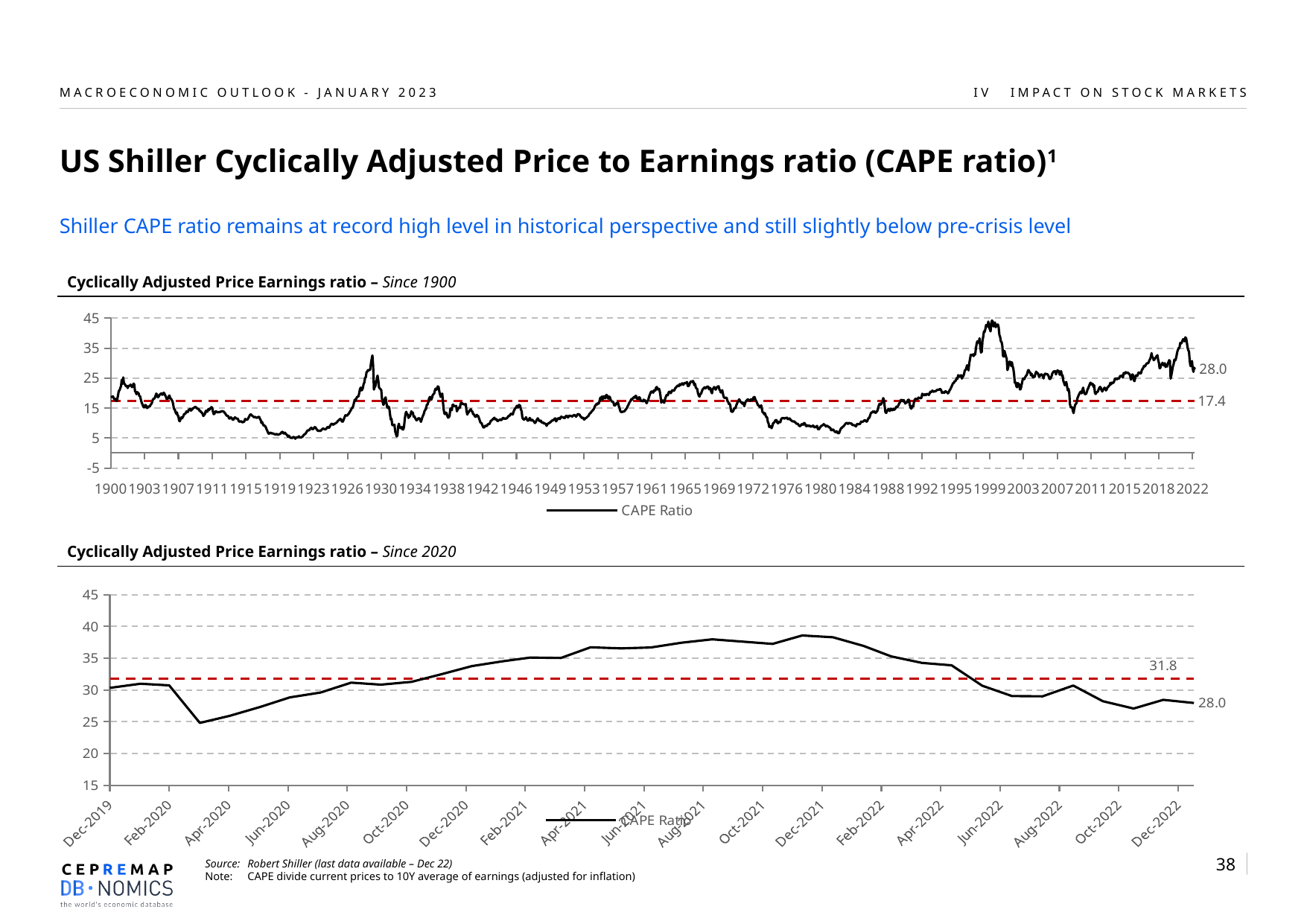
In the 'Since 2020' chart, what is the difference between the dashed line value and the latest CAPE Ratio value? 3.8 In the 'Since 1900' chart, what is the latest CAPE Ratio value labelled at the end of the line? 28.0 How many series does the legend of the 'Since 2020' chart list? 1 In the 'Since 1900' chart, what value is labelled on the dashed red horizontal line? 17.4 In the 'Since 2020' chart, does the CAPE Ratio rise or fall between Dec-2021 and Dec-2022? Fall In the 'Since 2020' chart, at which x-axis label is the CAPE Ratio lowest? Apr-2020 In the 'Since 1900' chart, how much higher is the latest CAPE Ratio value than the dashed line value? 10.6 What type of chart is the 'Since 1900' chart? Line chart In the 'Since 2020' chart, is the CAPE Ratio value for Apr-2020 greater or less than 30? less In the 'Since 2020' chart, is the CAPE Ratio value for Dec-2021 greater or less than 35? greater In the 'Since 2020' chart, what is the latest CAPE Ratio value labelled at the end of the line? 28.0 In the 'Since 2020' chart, what value is labelled on the dashed red horizontal line? 31.8